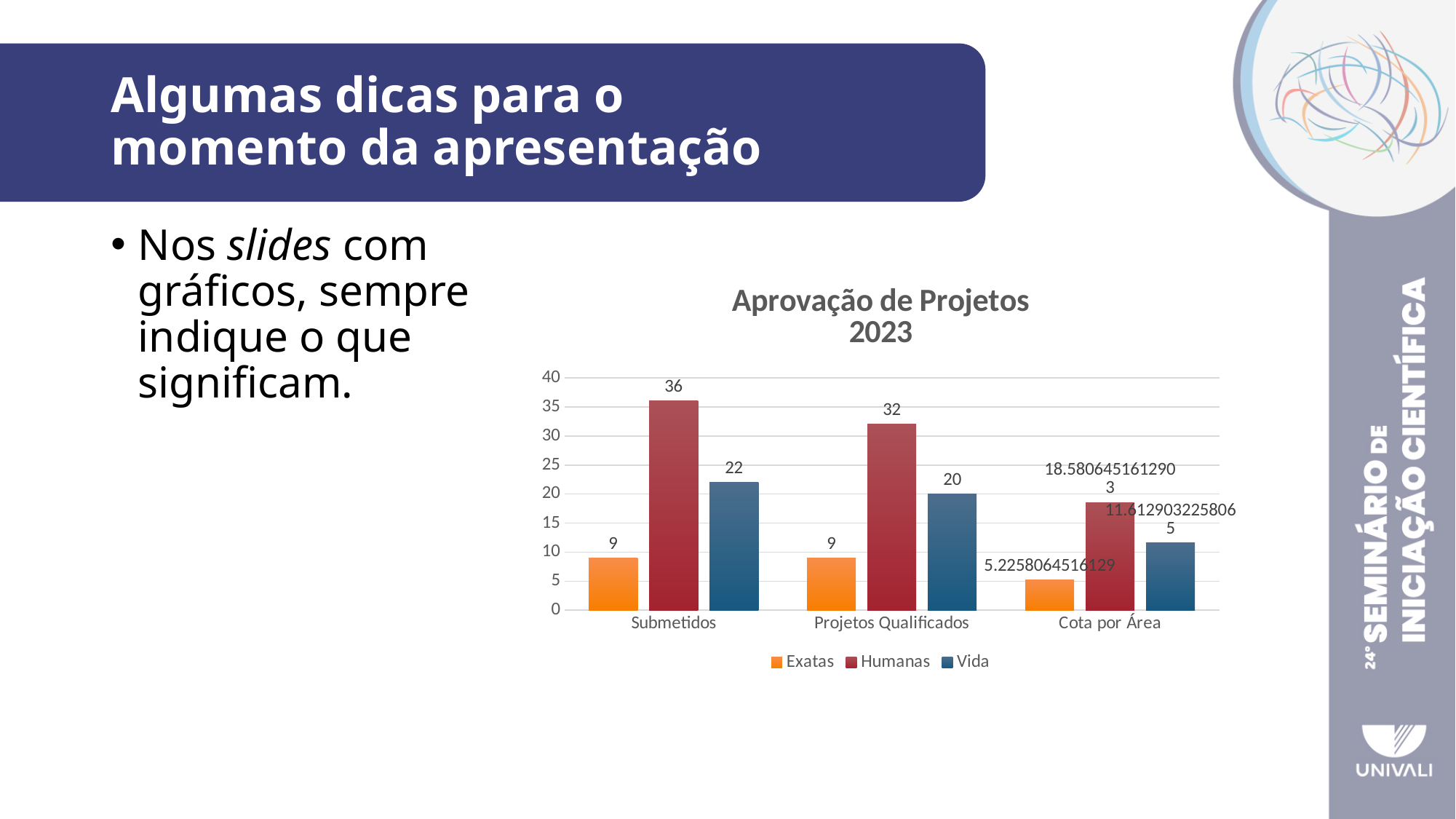
Which series has the highest value in the Projetos Qualificados category? Humanas What is the value for Exatas in the Submetidos category? 9 What is the difference between the Humanas and Vida values in the Submetidos category? 14 Which series has the lowest value in the Cota por Área category? Exatas How many series does the legend list? 3 What type of chart is shown on the slide? Bar chart What is the value for Vida in the Projetos Qualificados category? 20 Is the value for Exatas in the Cota por Área category greater or less than 10? less How many categories are shown on the x axis of the chart? 3 Which is larger: the Vida value for Submetidos or the Vida value for Projetos Qualificados? Submetidos What is the value for Humanas in the Submetidos category? 36 Is the value for Humanas in the Cota por Área category greater or less than 15? greater